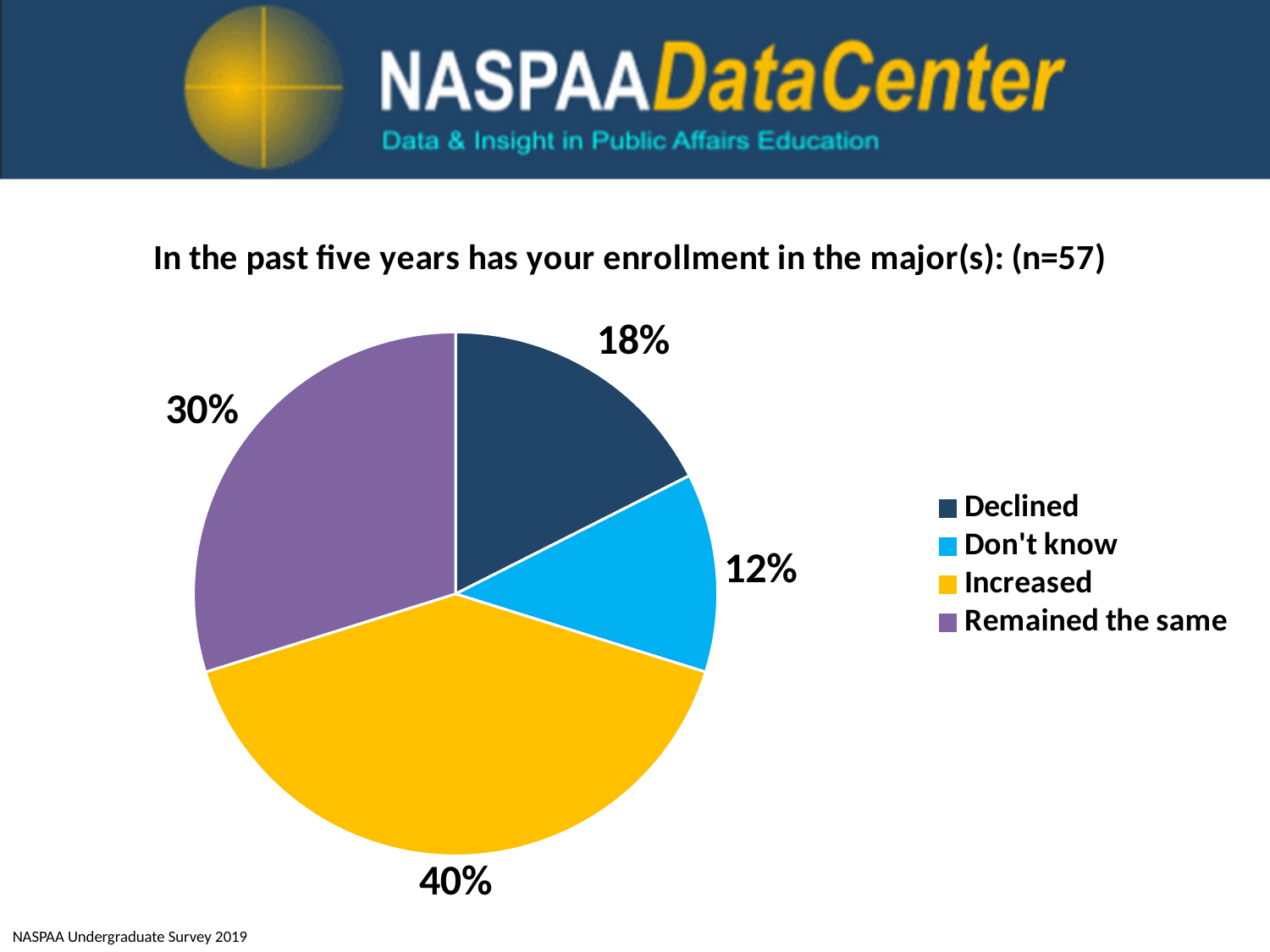
What percentage of respondents said enrollment Declined? 18% What colour is the slice for Remained the same? purple Which response has the smallest share of the pie? Don't know What percentage of respondents answered Don't know? 12% How many categories does the pie chart have? 4 Which response has the largest share of the pie? Increased What kind of chart is shown on the slide? pie chart Which is larger, the share for Declined or the share for Don't know? Declined What is the difference in percentage points between Increased and Remained the same? 10 What percentage of respondents said enrollment Increased? 40% What percentage of respondents said enrollment Remained the same? 30% What is the sample size (n) given in the chart title? 57